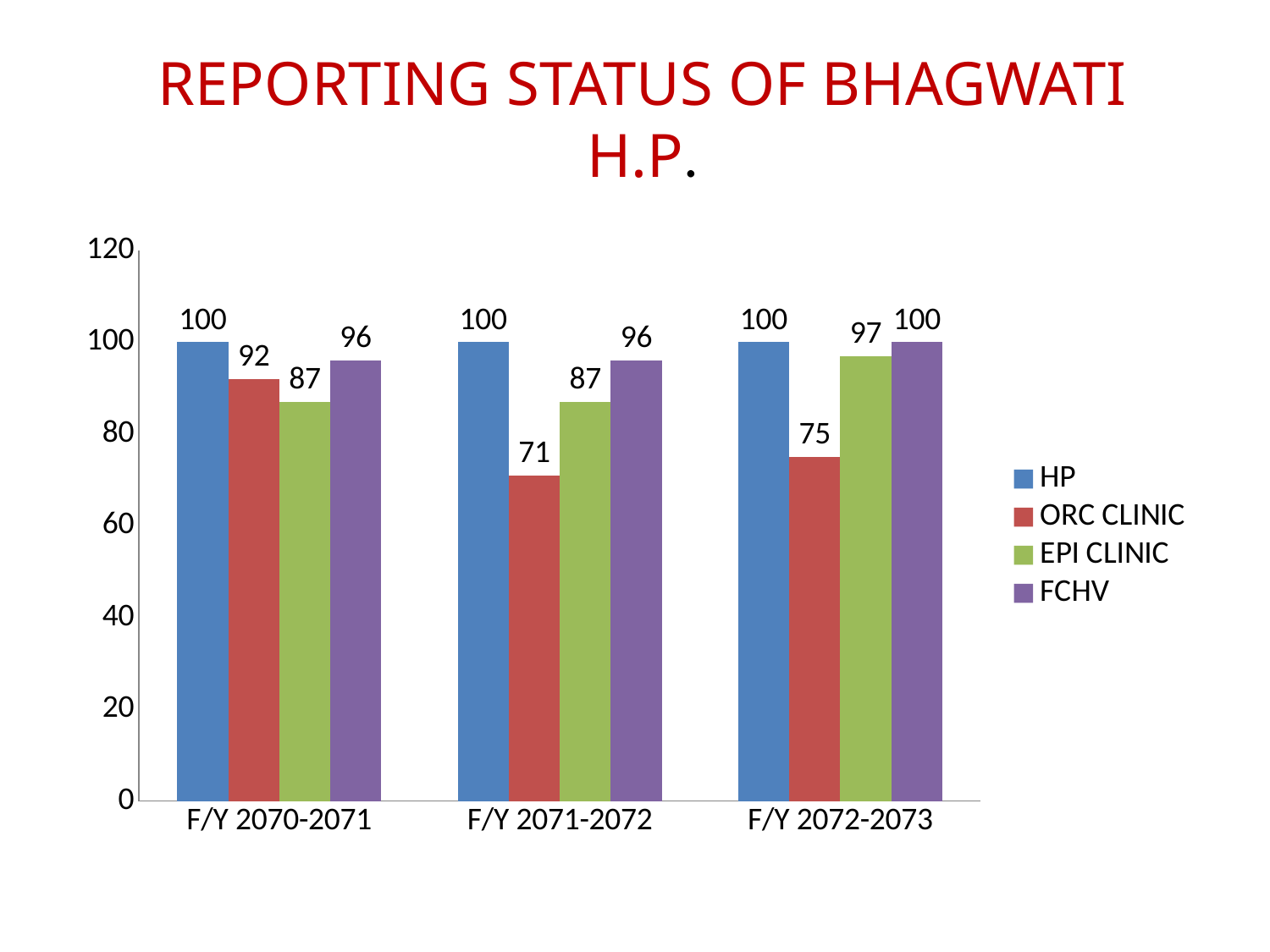
What is the value for FCHV in F/Y 2070-2071? 96 Which series has the lowest value in F/Y 2071-2072? ORC CLINIC What is the value for EPI CLINIC in F/Y 2072-2073? 97 Which is larger in F/Y 2070-2071, the ORC CLINIC value or the EPI CLINIC value? ORC CLINIC Does the ORC CLINIC value rise or fall from F/Y 2070-2071 to F/Y 2071-2072? Fall What is the difference between the HP value and the ORC CLINIC value in F/Y 2072-2073? 25 What kind of chart is shown on the slide? Bar chart What is the value for ORC CLINIC in F/Y 2071-2072? 71 What is the title of the slide? REPORTING STATUS OF BHAGWATI H.P. How many fiscal year categories are shown on the x axis? 3 How many series does the legend list? 4 Which series has the lowest value in F/Y 2070-2071? EPI CLINIC